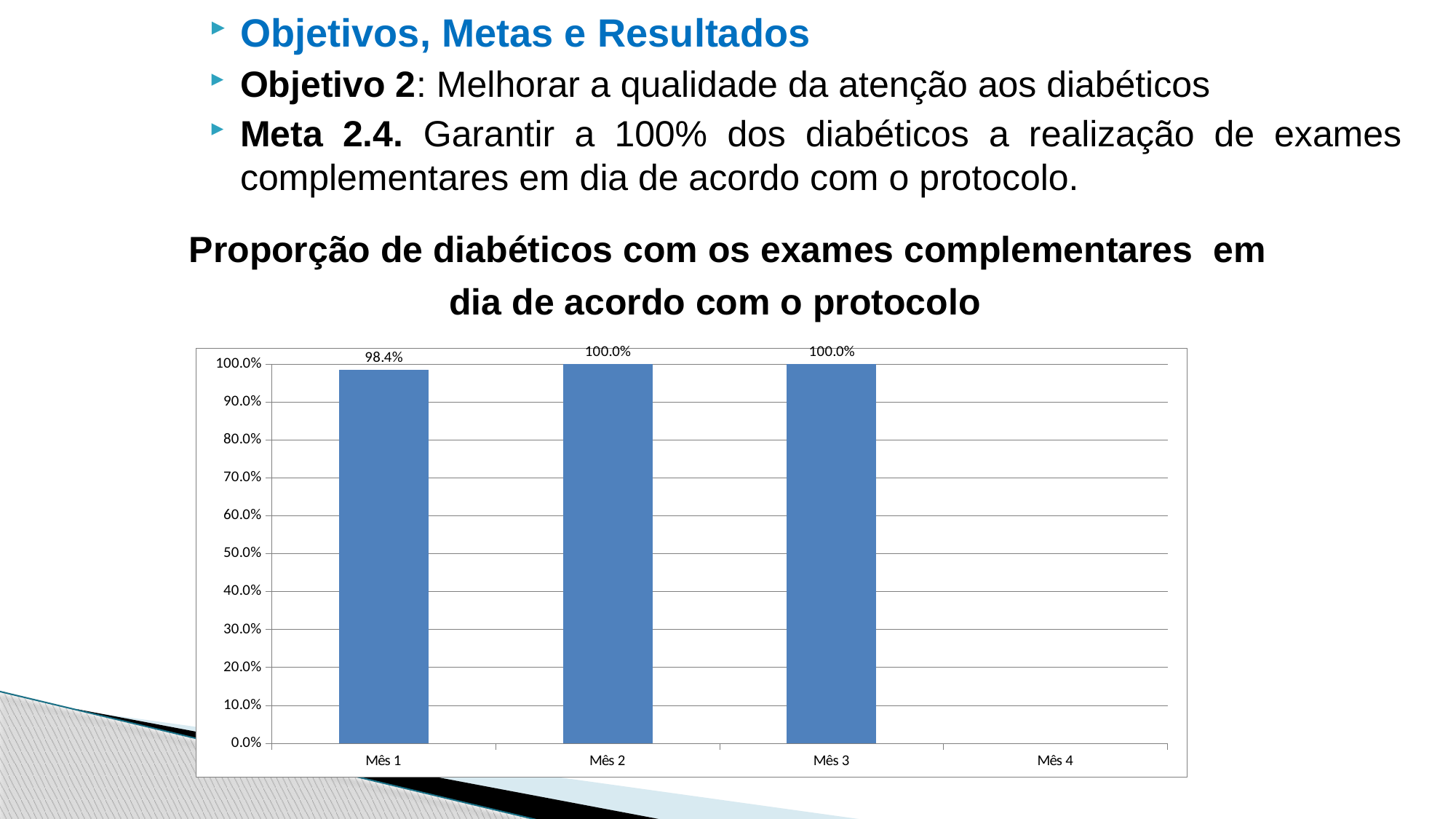
What is the difference between the values for Mês 2 and Mês 1? 1.6% Is the value for Mês 1 greater or less than 90.0%? greater How many bars are plotted in the chart? 3 What kind of chart is shown on the slide? Bar chart Do the values rise or fall from Mês 1 to Mês 2? Rise What is the value for Mês 2 in the chart? 100.0% What is the value for Mês 3 in the chart? 100.0% Which month has the lowest value among the plotted bars? Mês 1 What is the title of the chart? Proporção de diabéticos com os exames complementares em dia de acordo com o protocolo Which is larger, the value for Mês 1 or the value for Mês 2? Mês 2 What is the value for Mês 1 in the chart? 98.4% How many month categories are labelled on the x axis? 4